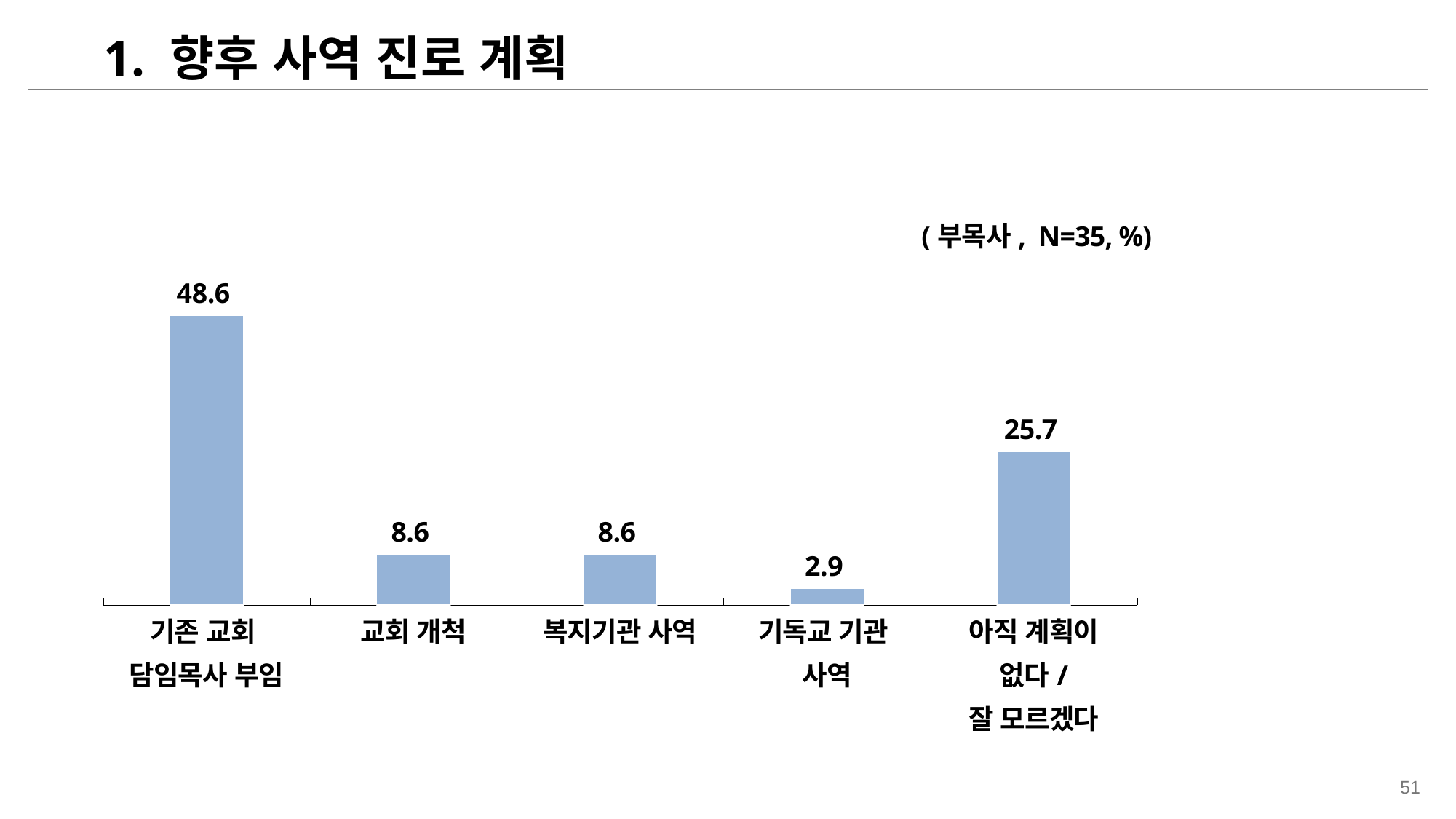
How many categories are shown in the chart? 5 What is the difference between the values for 기존 교회 담임목사 부임 and 아직 계획이 없다 / 잘 모르겠다? 22.9 What is the value for 아직 계획이 없다 / 잘 모르겠다? 25.7 What is the value for 기존 교회 담임목사 부임? 48.6 What is the sample size (N) noted on the chart? 35 What is the value for 교회 개척? 8.6 Which category has the lowest value? 기독교 기관 사역 What kind of chart is shown on the slide? Bar chart What is the title of the slide? 1. 향후 사역 진로 계획 Which category has the highest value? 기존 교회 담임목사 부임 What is the value for 기독교 기관 사역? 2.9 Which is larger, the value for 복지기관 사역 or the value for 기독교 기관 사역? 복지기관 사역